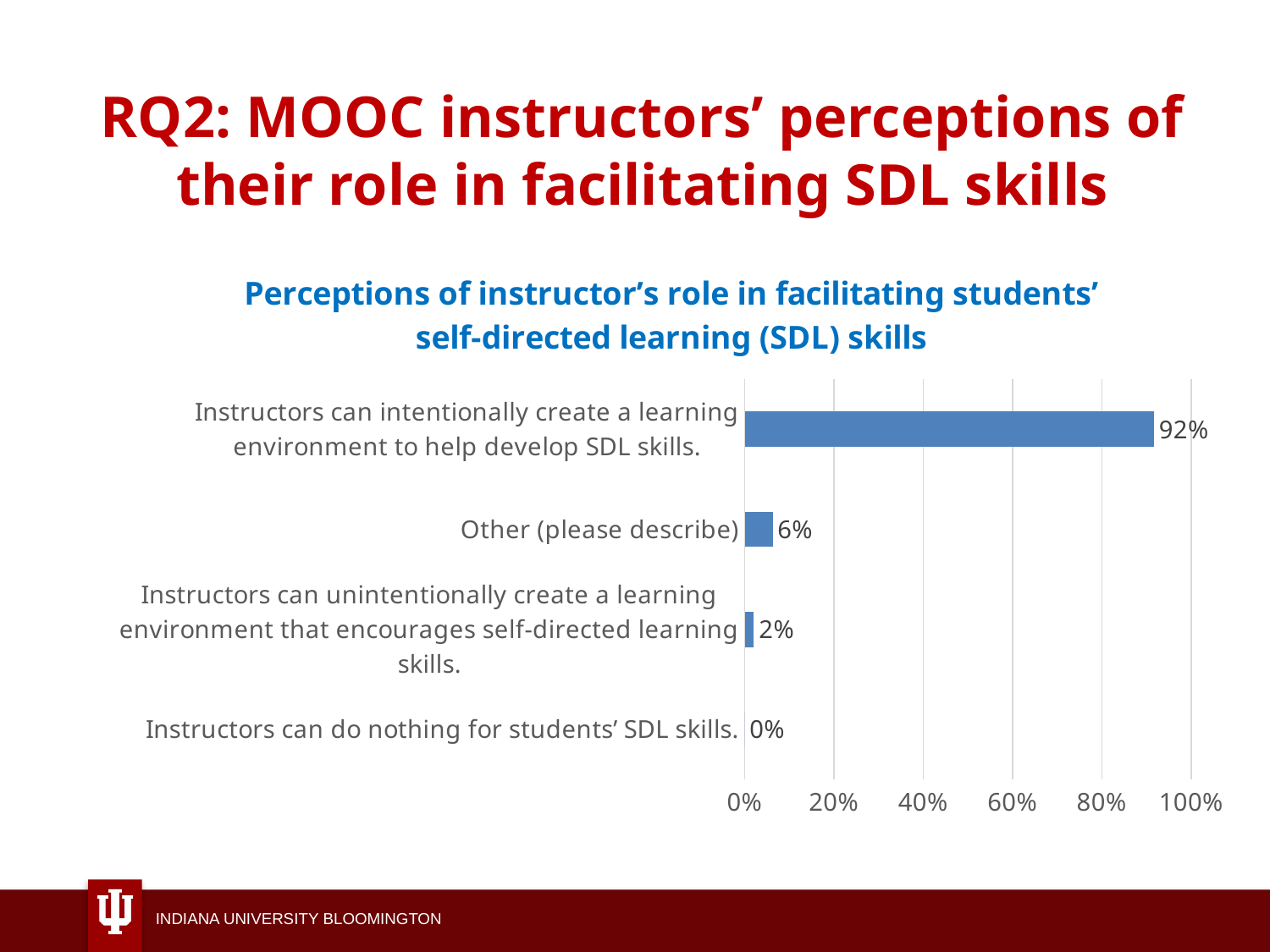
Is the value for intentionally creating a learning environment greater or less than 80%? greater Which is larger: the value for "Other (please describe)" or the value for unintentionally creating a learning environment? Other (please describe) What value is shown for "Instructors can do nothing for students' SDL skills"? 0% What type of chart is shown on the slide? Bar chart What percentage of instructors said they can intentionally create a learning environment to help develop SDL skills? 92% What value is shown for "Other (please describe)"? 6% Which category has the highest value? Instructors can intentionally create a learning environment to help develop SDL skills. What is the title of the chart? Perceptions of instructor's role in facilitating students' self-directed learning (SDL) skills What percentage is shown for instructors unintentionally creating a learning environment that encourages self-directed learning skills? 2% How many categories are shown in the chart? 4 Which category has the lowest value? Instructors can do nothing for students' SDL skills. What is the difference between the value for intentionally creating a learning environment and the value for "Other (please describe)"? 86%